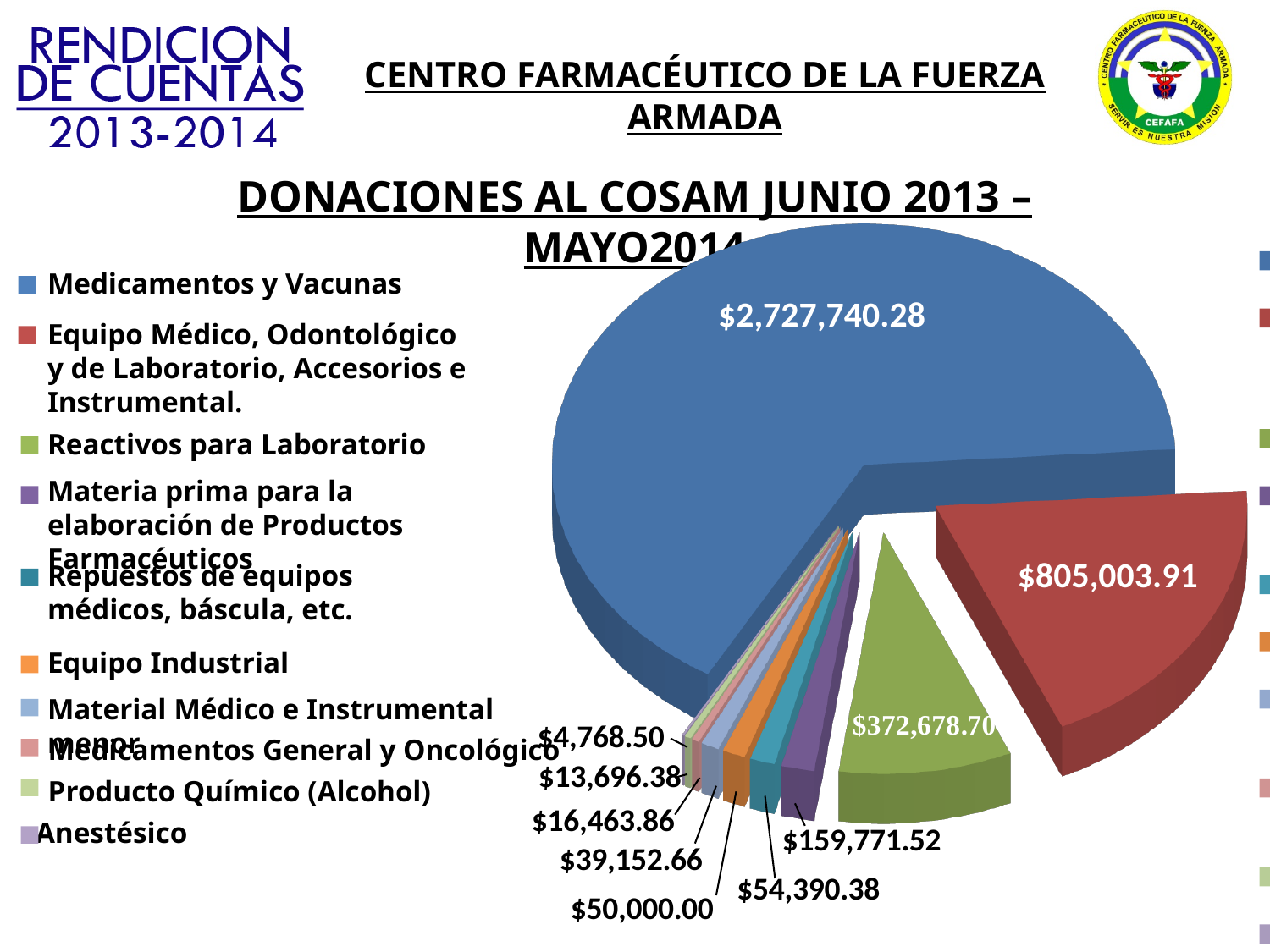
What is the value of the Medicamentos y Vacunas slice? $2,727,740.28 What is the title of the chart? DONACIONES AL COSAM JUNIO 2013 – MAYO2014 What is the value of the Reactivos para Laboratorio slice? $372,678.70 What is the value of the Materia prima para la elaboración de Productos Farmacéuticos slice? $159,771.52 Which is larger, the Reactivos para Laboratorio slice or the Materia prima para la elaboración de Productos Farmacéuticos slice? Reactivos para Laboratorio What is the difference between the Equipo Médico, Odontológico y de Laboratorio, Accesorios e Instrumental value and the Reactivos para Laboratorio value? $432,325.21 What is the smallest value shown on the pie chart? $4,768.50 Which category has the largest slice of the pie? Medicamentos y Vacunas How many categories does the legend list? 10 What kind of chart is shown on the slide? Pie chart What is the value of the Equipo Médico, Odontológico y de Laboratorio, Accesorios e Instrumental slice? $805,003.91 What is the difference between the Medicamentos y Vacunas value and the Equipo Médico, Odontológico y de Laboratorio, Accesorios e Instrumental value? $1,922,736.37